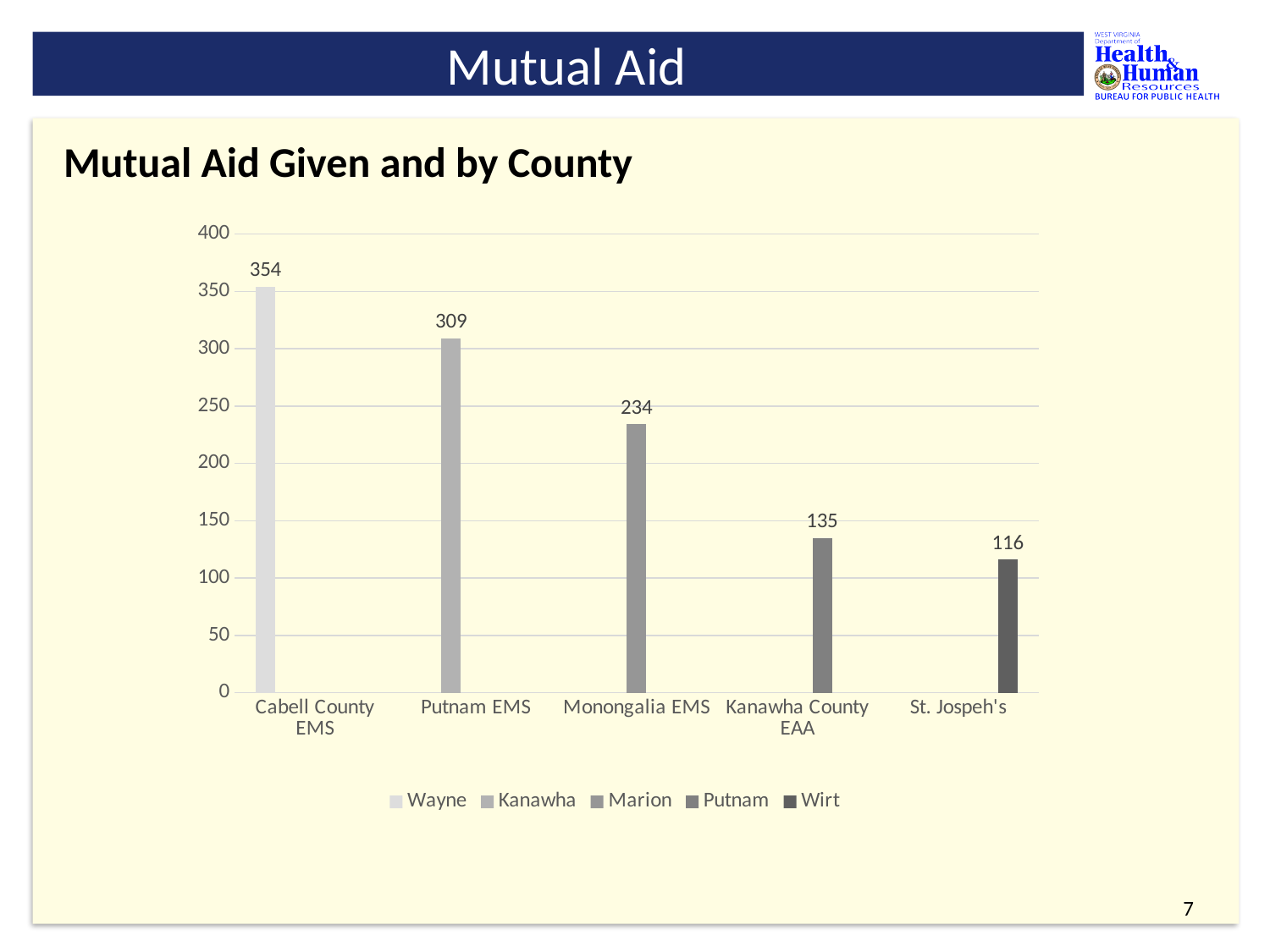
What is the difference between the values for Kanawha County EAA and St. Jospeh's? 19 What is the value for Cabell County EMS? 354 How many entries does the legend list? 5 What is the value for Monongalia EMS? 234 What kind of chart is shown on the slide? Bar chart Which category has the highest value? Cabell County EMS Which category has the lowest value? St. Jospeh's How many categories are shown on the x axis? 5 What is the difference between the values for Cabell County EMS and Putnam EMS? 45 Which is larger, the value for Putnam EMS or the value for Monongalia EMS? Putnam EMS Do the values rise or fall from left to right along the x axis? Fall What is the value for St. Jospeh's? 116